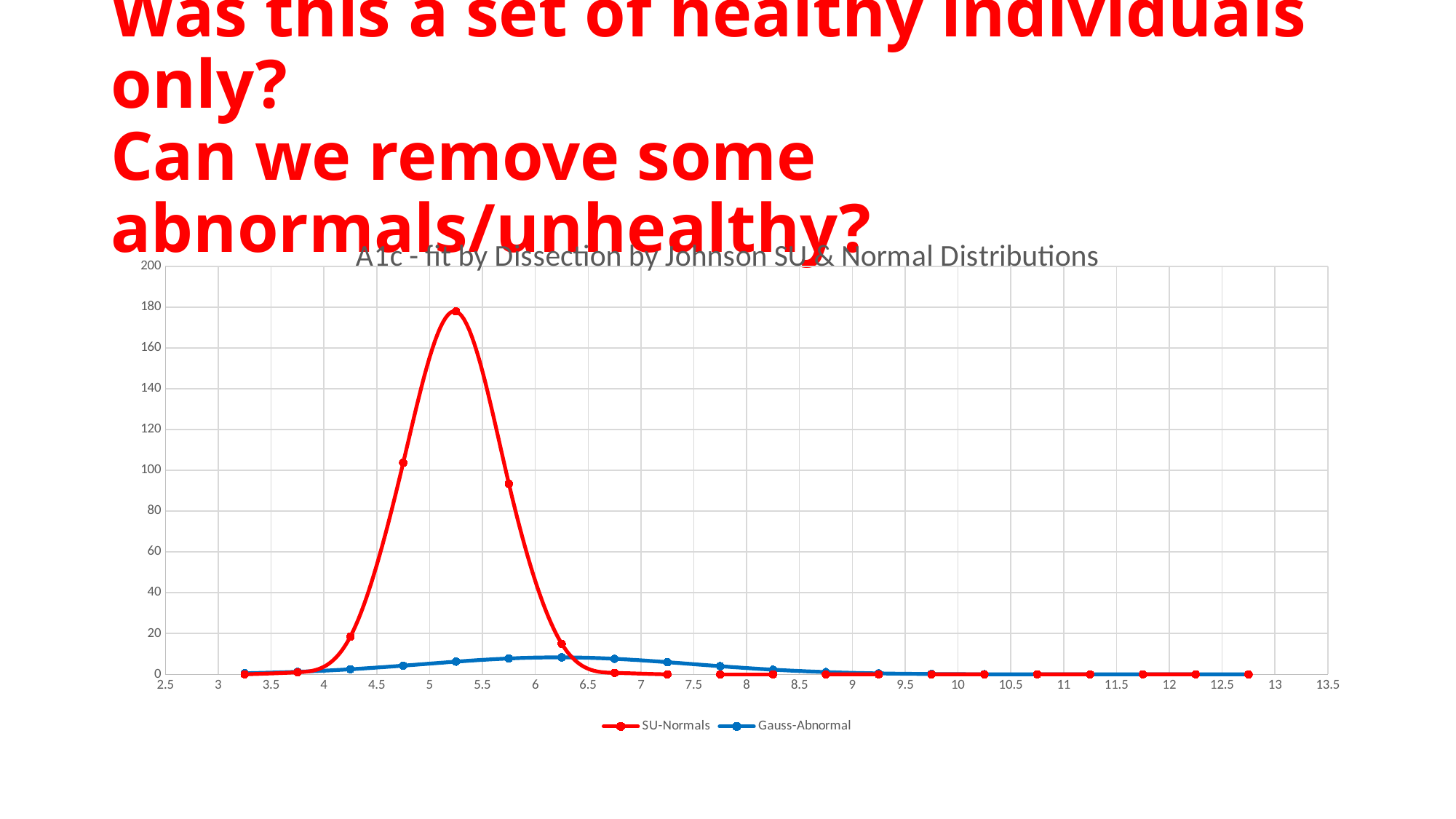
How many data points are plotted for the SU-Normals series? 20 What is the title of the chart? A1c - fit by Dissection by Johnson SU & Normal Distributions Do the SU-Normals values rise or fall as x increases from 5.25 to 7.25? fall Is the peak value of the SU-Normals series greater or less than 160? greater Is the value of the SU-Normals series at x = 5.75 greater or less than 100? less Is the value of the SU-Normals series at x = 4.75 greater or less than 100? greater At x = 5.25, which series has the larger value, SU-Normals or Gauss-Abnormal? SU-Normals Which series is drawn in red? SU-Normals How many series does the legend list? 2 What kind of chart is shown on the slide? line chart Which series reaches the highest value on the chart? SU-Normals